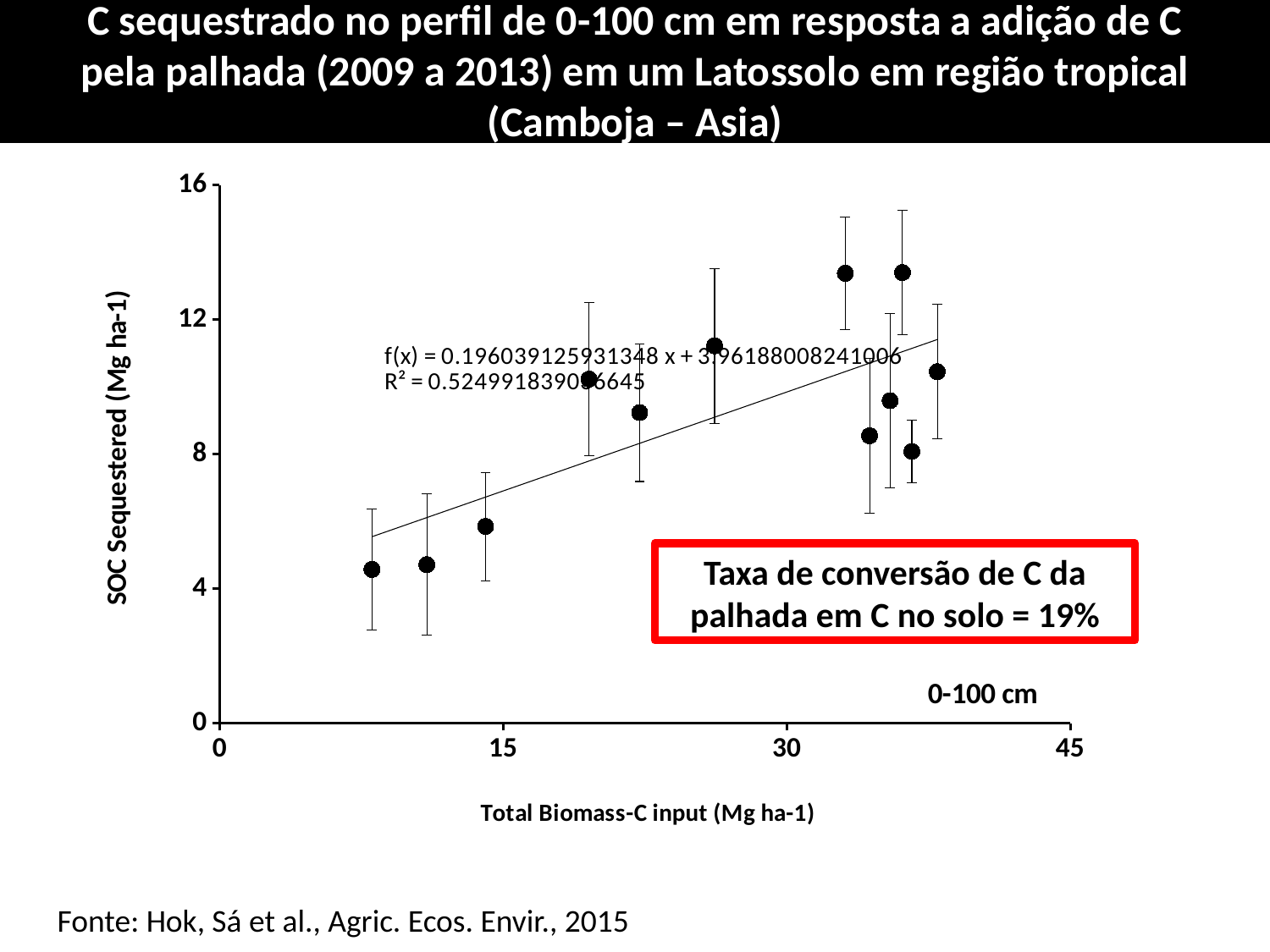
What is the slope of the fitted line shown in the equation on the chart? 0.196039125931348 Is the SOC Sequestered value for the point at a Total Biomass-C input of about 26 Mg ha-1 greater or less than 8? greater What R² value is printed on the chart? 0.524991839096645 What is the label of the x axis? Total Biomass-C input (Mg ha-1) What is the highest tick value shown on the x axis? 45 What kind of chart is shown on the slide? scatter plot Do the SOC Sequestered values generally rise or fall as Total Biomass-C input increases? rise What conversion rate of straw C to soil C is stated in the red box? 19% How many data points are plotted on the chart? 12 Is the SOC Sequestered value for the point at a Total Biomass-C input of about 14 Mg ha-1 greater or less than 8? less What is the label of the y axis? SOC Sequestered (Mg ha-1) Is the SOC Sequestered value for the point at a Total Biomass-C input of about 33 Mg ha-1 greater or less than 12? greater